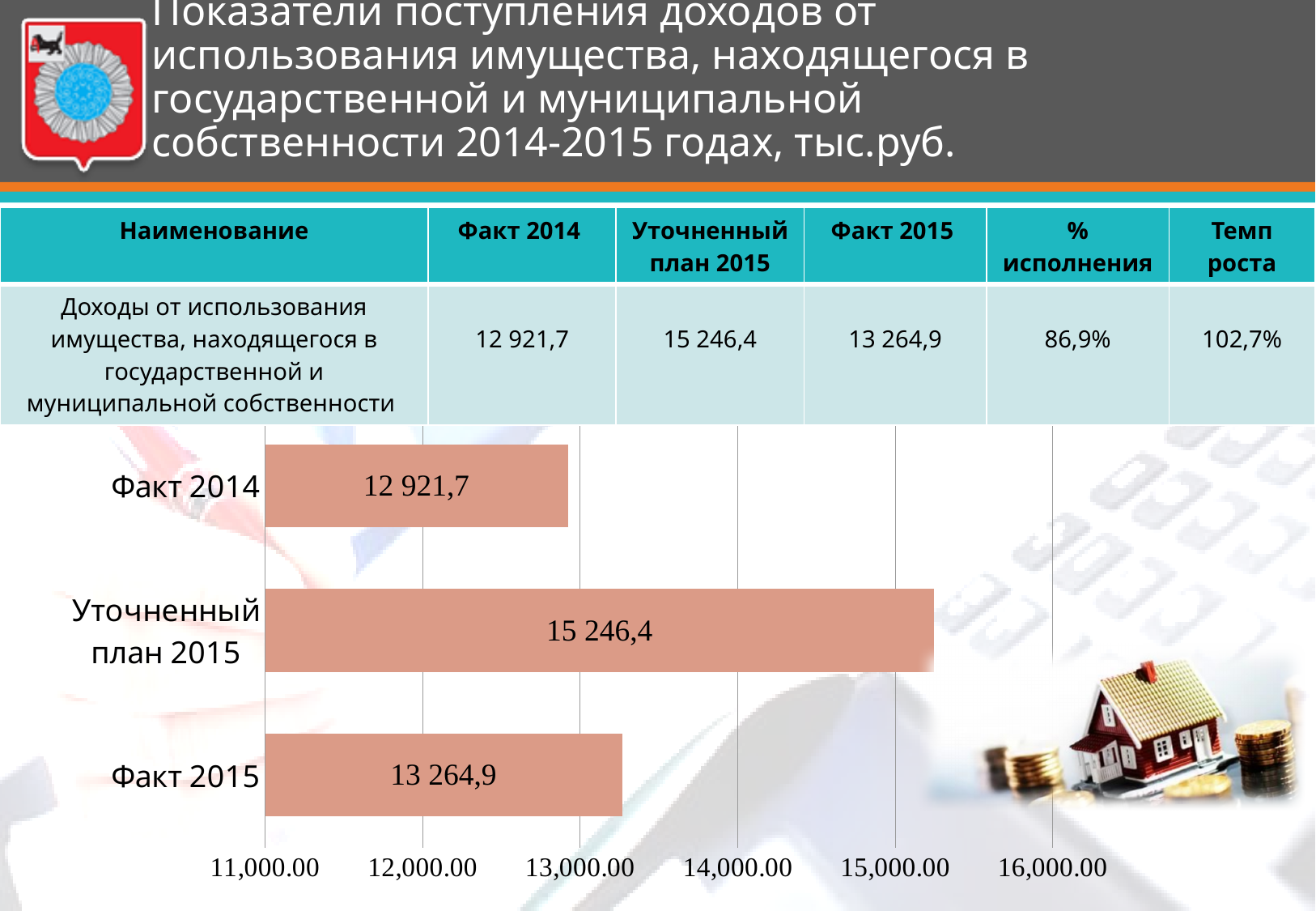
Which is larger, the value for Факт 2015 or the value for Факт 2014? Факт 2015 What is the value of the bar for Факт 2014? 12 921,7 How many bars are shown in the chart? 3 Is the value for Уточненный план 2015 greater or less than 15,000.00? greater What is the value of the bar for Уточненный план 2015? 15 246,4 What is the lowest value shown on the chart's horizontal axis? 11,000.00 What is the value of the bar for Факт 2015? 13 264,9 What is the difference between the values for Факт 2015 and Факт 2014? 343,2 Which category has the highest value in the chart? Уточненный план 2015 What type of chart is shown on the slide? bar chart What is the difference between the values for Уточненный план 2015 and Факт 2015? 1 981,5 Which category has the lowest value in the chart? Факт 2014